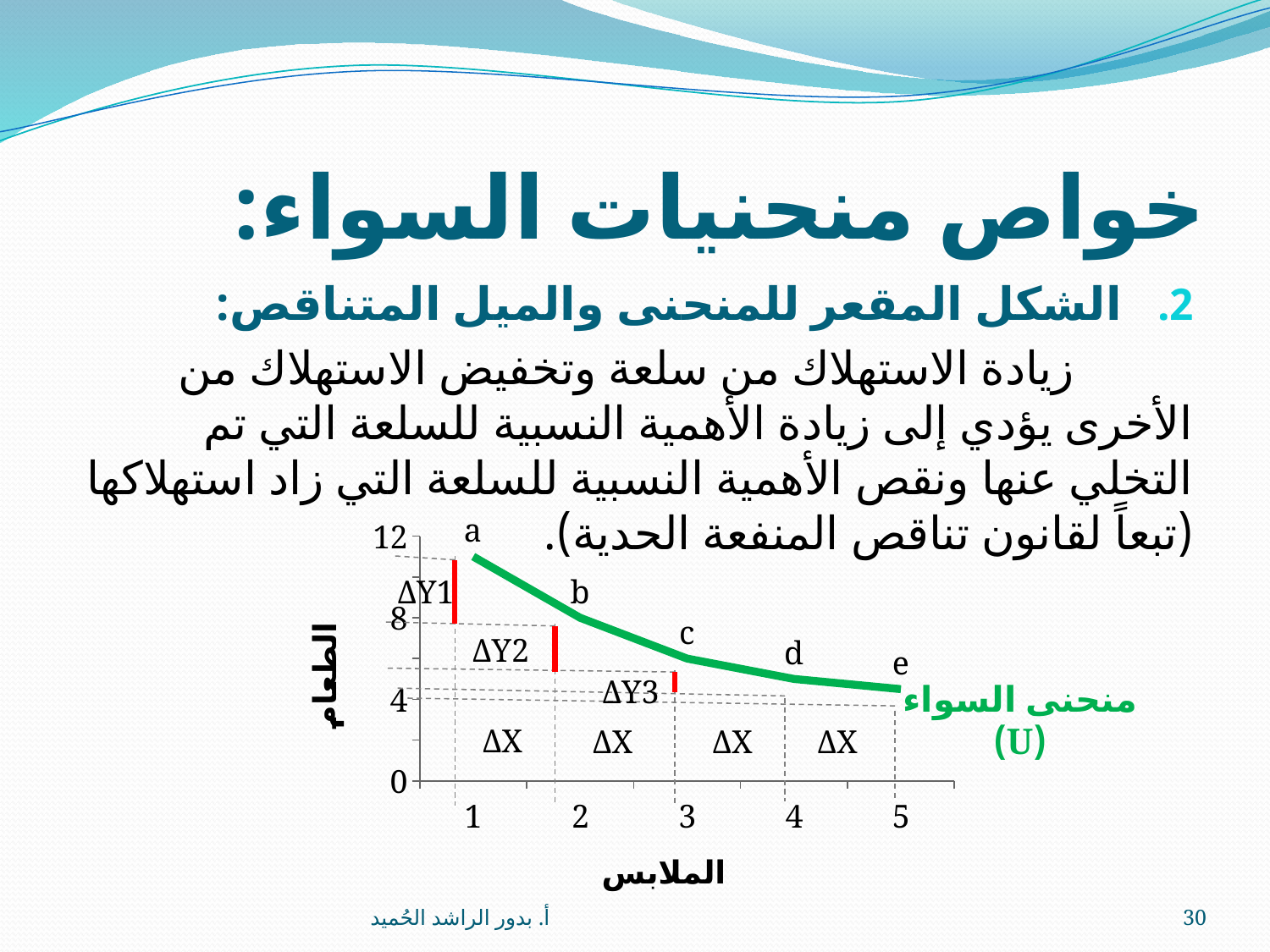
How many labelled points (a to e) are marked on the curve? 5 What is the label of the x axis? الملابس Which labelled point on the curve has the highest value? a Which is larger, the value at point a or the value at point c? a Is the value at point a greater or less than 8? greater Which labelled point on the curve has the lowest value? e Which is larger, the value at point b or the value at point d? b What kind of chart is shown on the slide? line chart Is the value at point c greater or less than 4? greater What is the label of the y axis? الطعام Do the values on the curve rise or fall as the x axis increases from 1 to 5? fall Is the value at point c greater or less than 8? less